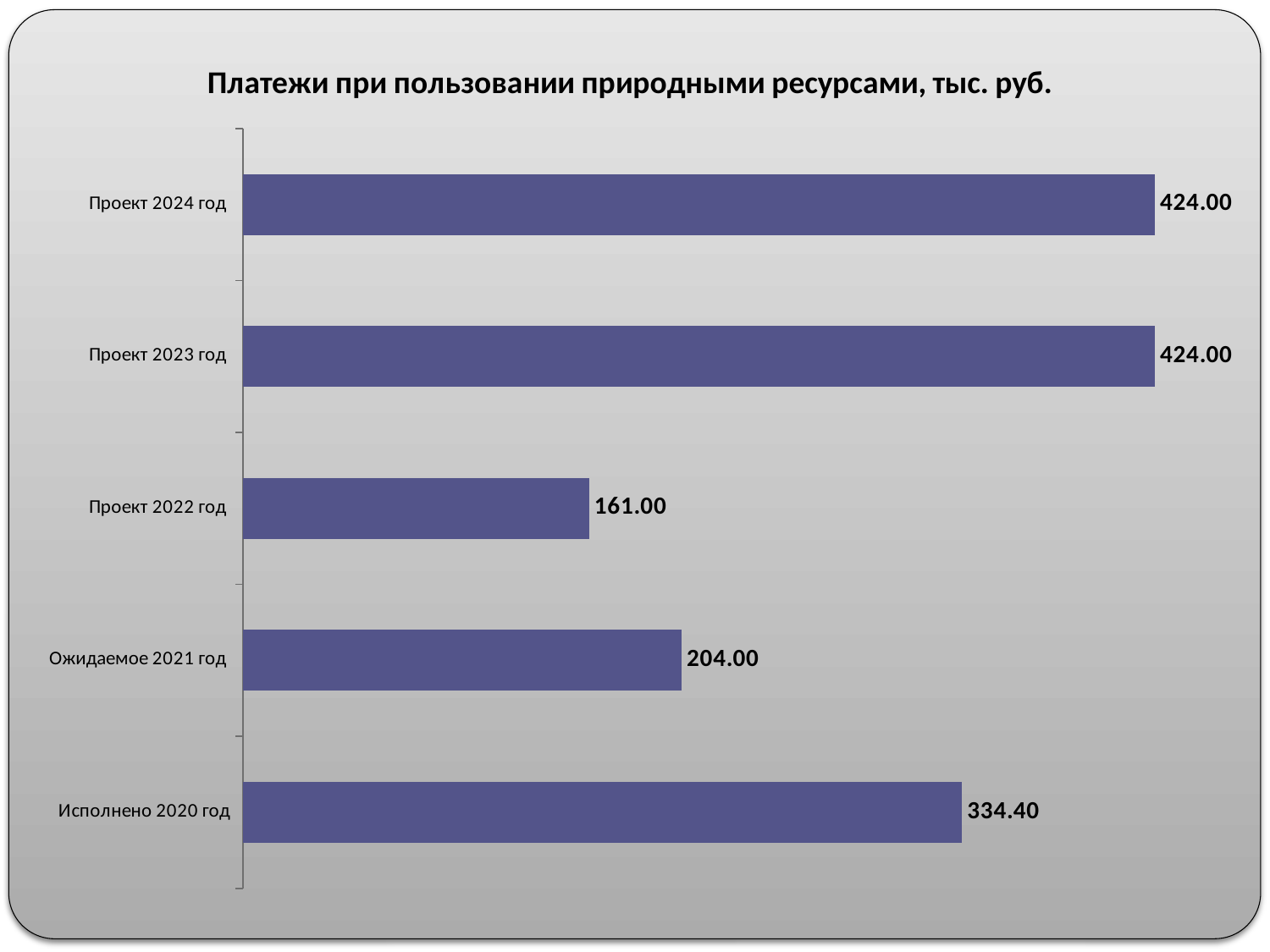
What is the value for Исполнено 2020 год? 334.40 Which category has the lowest value? Проект 2022 год What is the difference between the values for Исполнено 2020 год and Ожидаемое 2021 год? 130.40 What is the value for Проект 2024 год? 424.00 How many categories are shown in the chart? 5 What is the title of the chart? Платежи при пользовании природными ресурсами, тыс. руб. What is the value for Ожидаемое 2021 год? 204.00 Which is larger, the value for Исполнено 2020 год or the value for Ожидаемое 2021 год? Исполнено 2020 год What is the value for Проект 2022 год? 161.00 Which is larger, the value for Проект 2022 год or the value for Ожидаемое 2021 год? Ожидаемое 2021 год What kind of chart is shown on the slide? Bar chart What is the difference between the values for Проект 2023 год and Проект 2022 год? 263.00